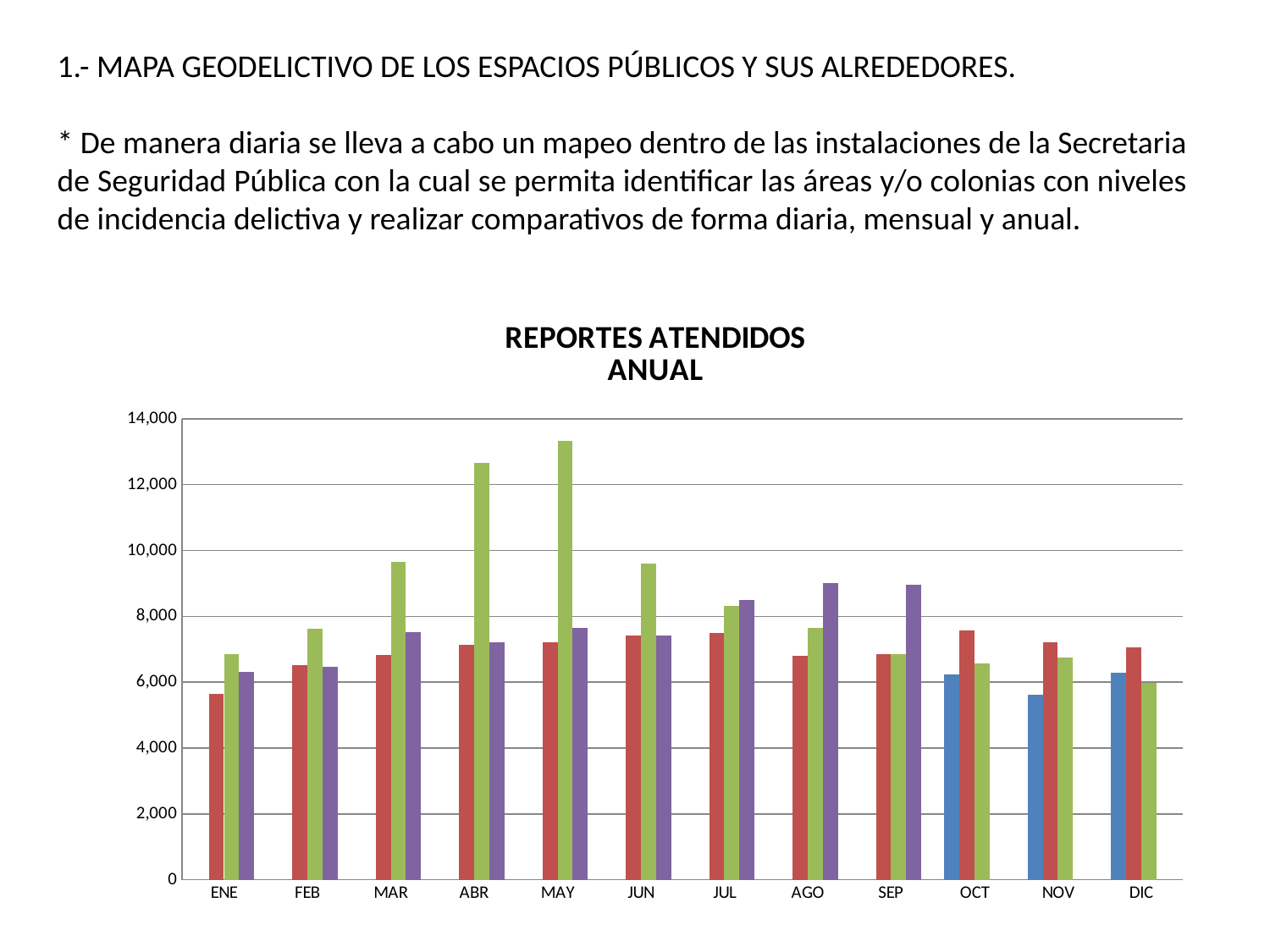
Which is larger, the green bar for ABR or the green bar for MAY? MAY Among the months with a blue bar, which month has the lowest blue bar? NOV Is the purple bar for AGO greater or less than 8,000? greater What is the title of the chart? REPORTES ATENDIDOS ANUAL In which month does the green series reach its highest value? MAY Is the red bar for ENE greater or less than 6,000? less Do the red bars rise or fall from ENE to JUL? rise Which is larger, the red bar for ENE or the red bar for FEB? FEB How many months (categories) are shown on the x axis of the chart? 12 Is the green bar for MAY greater or less than 12,000? greater What kind of chart is shown under the title REPORTES ATENDIDOS ANUAL? bar chart